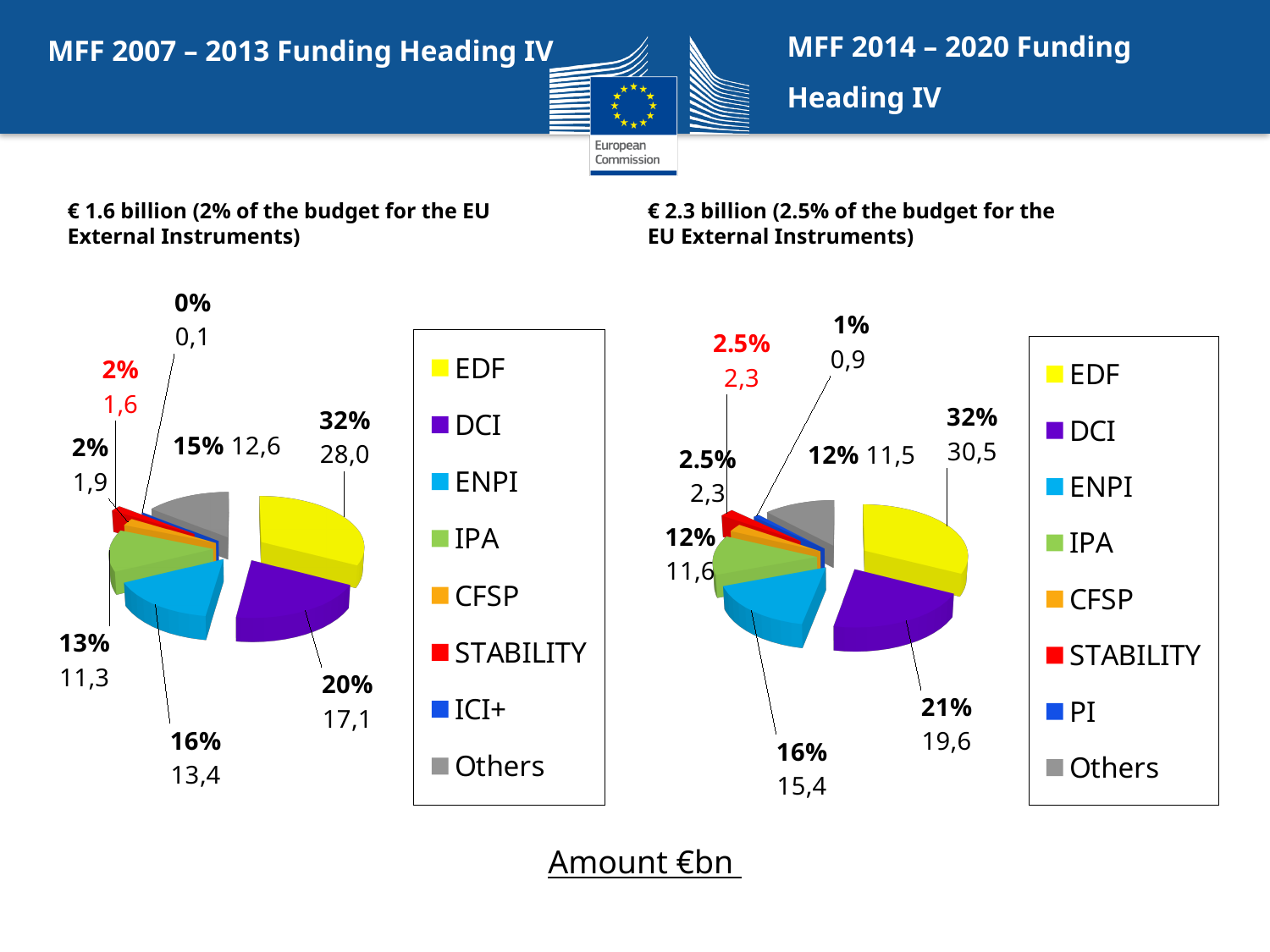
Which legend entry appears in the MFF 2014 – 2020 Funding Heading IV chart in place of ICI+ from the MFF 2007 – 2013 chart? PI What is the difference in €bn between the EDF amount in the MFF 2014 – 2020 chart (30,5) and the EDF amount in the MFF 2007 – 2013 chart (28,0)? 2,5 In the MFF 2014 – 2020 Funding Heading IV chart, which category has the smallest slice? PI In the MFF 2014 – 2020 Funding Heading IV chart, what share of the pie does ENPI have? 16% In the MFF 2007 – 2013 Funding Heading IV chart, what share of the pie does DCI have? 20% How many entries does the legend of the MFF 2007 – 2013 Funding Heading IV chart list? 8 What kind of charts are shown on the slide? Pie charts In the MFF 2007 – 2013 Funding Heading IV chart, which category has the smallest slice? ICI+ In the MFF 2007 – 2013 Funding Heading IV chart, what amount in €bn is shown for EDF? 28,0 In the MFF 2014 – 2020 Funding Heading IV chart, what amount in €bn is shown for DCI? 19,6 In the MFF 2007 – 2013 Funding Heading IV chart, which category has the largest slice? EDF In the MFF 2014 – 2020 Funding Heading IV chart, which is larger, the amount for IPA or the amount for Others? IPA